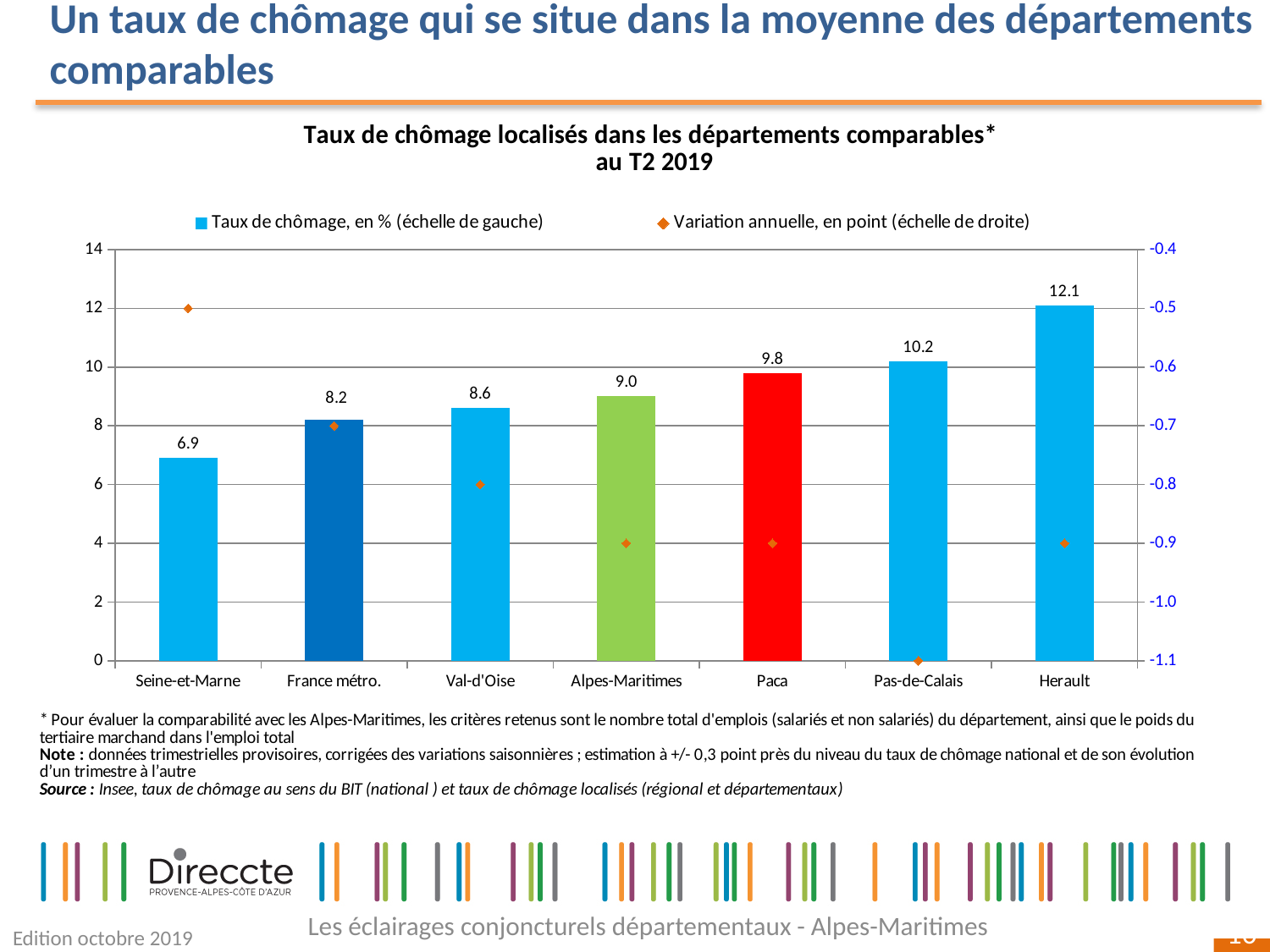
How many categories are shown on the x axis of the chart? 7 What is the difference between the unemployment rates of Paca and Val-d'Oise? 1.2 What kind of chart is used to show the unemployment rates? Bar chart Which has a higher unemployment rate, Pas-de-Calais or Alpes-Maritimes? Pas-de-Calais What is the unemployment rate shown for Herault? 12.1 Which department has the highest unemployment rate on the chart? Herault How many series does the chart legend list? 2 What is the unemployment rate (taux de chômage) shown for Alpes-Maritimes? 9.0 What is the unemployment rate shown for France métro.? 8.2 What is the annual variation (variation annuelle, right axis) shown for Pas-de-Calais? -1.1 Which series is plotted on the right-hand axis according to the legend? Variation annuelle, en point (échelle de droite) Which category has the lowest unemployment rate on the chart? Seine-et-Marne